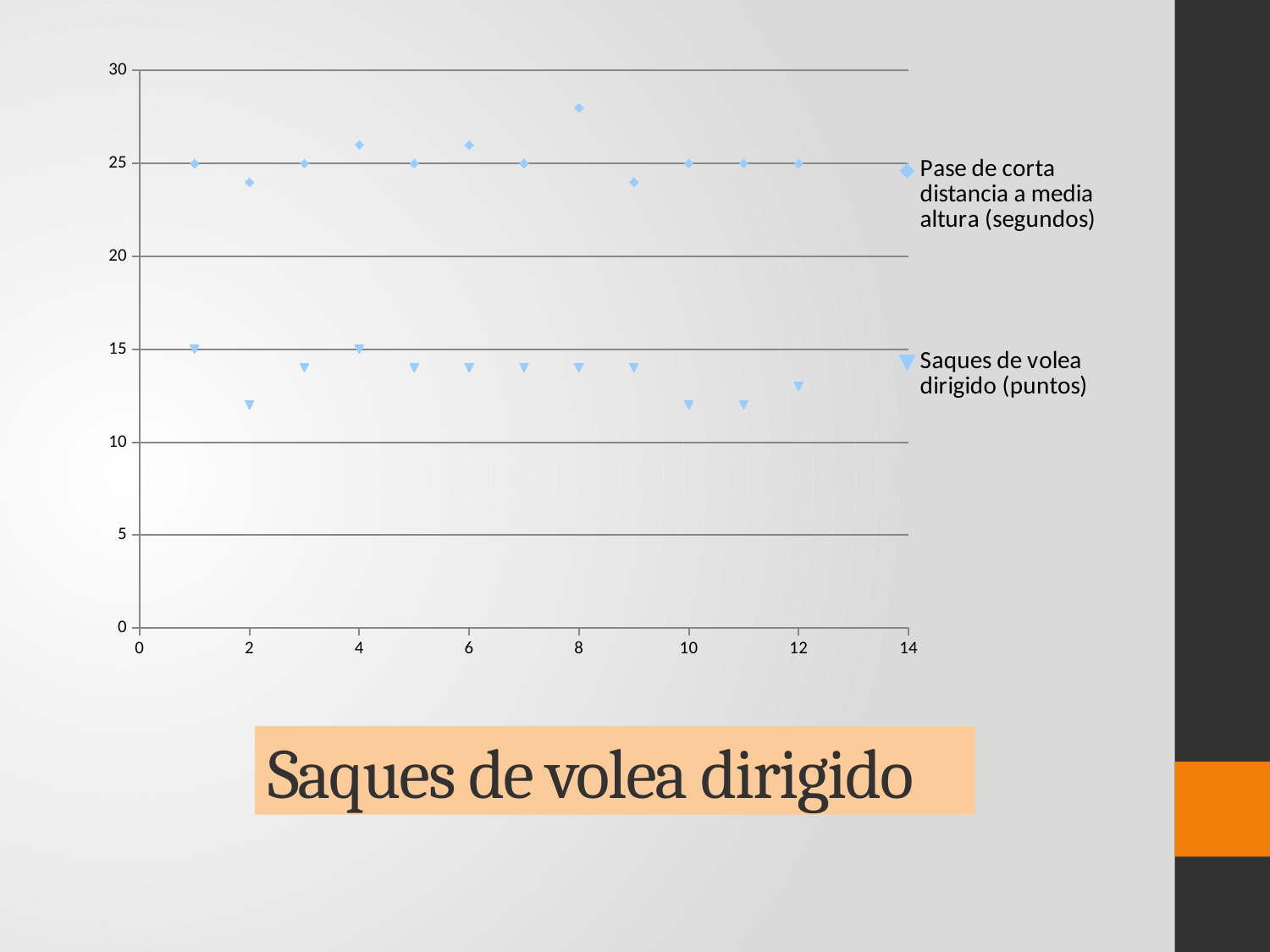
How many data points are plotted for the 'Pase de corta distancia a media altura (segundos)' series? 12 What is the value of 'Pase de corta distancia a media altura (segundos)' at x = 1? 25 Is the value for 'Saques de volea dirigido (puntos)' at x = 2 greater or less than 15? less Which series is plotted with triangle markers? Saques de volea dirigido (puntos) What kind of chart is shown on the slide? Scatter chart Is the value for 'Pase de corta distancia a media altura (segundos)' at x = 8 greater or less than 25? greater How many series does the legend list? 2 What is the value of 'Saques de volea dirigido (puntos)' at x = 1? 15 What is the title shown below the chart? Saques de volea dirigido At x = 8, which series has the larger value: 'Pase de corta distancia a media altura (segundos)' or 'Saques de volea dirigido (puntos)'? Pase de corta distancia a media altura (segundos) At which x value does the 'Pase de corta distancia a media altura (segundos)' series reach its highest point? 8 What is the value of 'Saques de volea dirigido (puntos)' at x = 4? 15